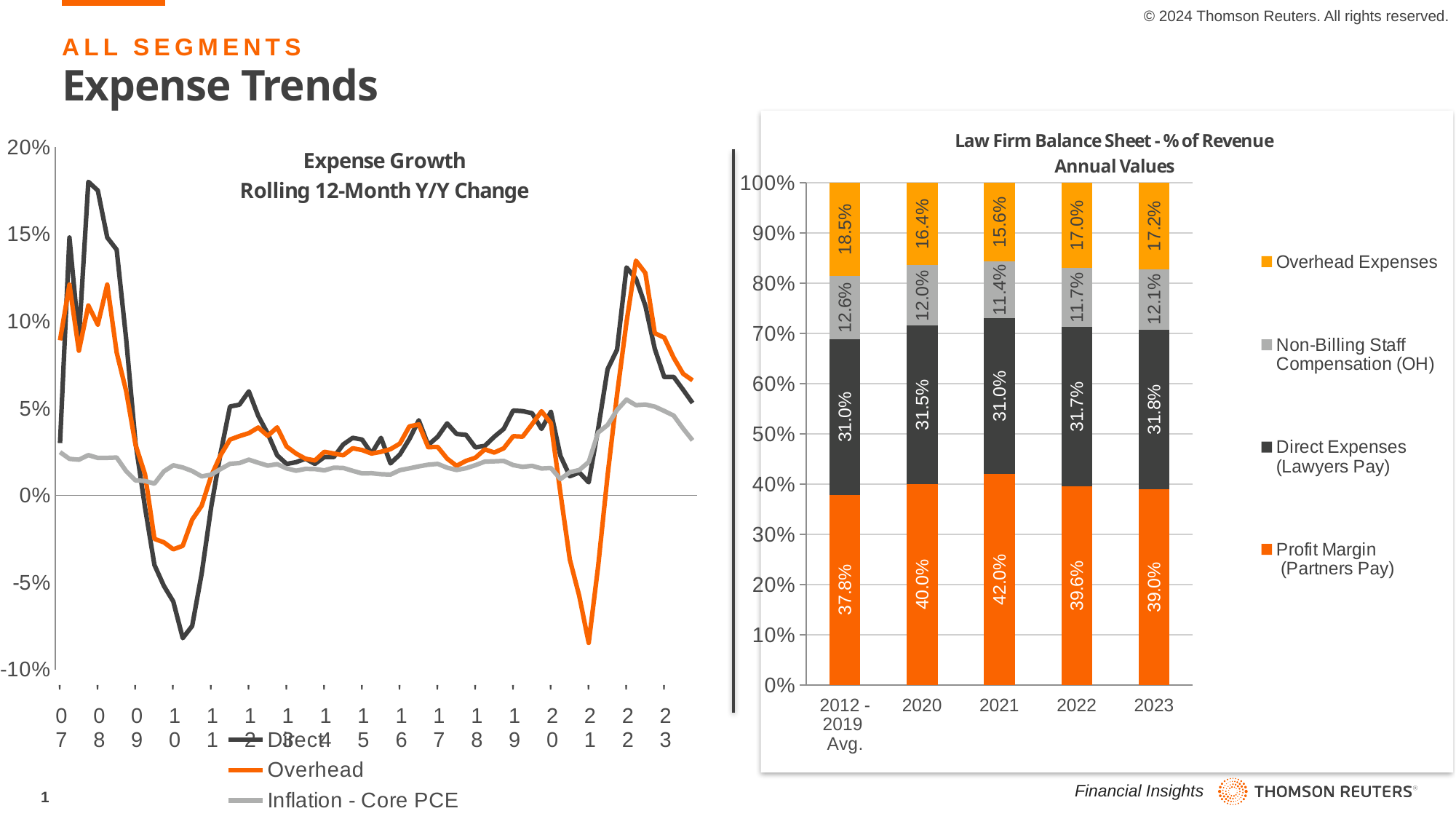
How many series does the legend of the 'Law Firm Balance Sheet - % of Revenue' chart list? 4 In the 'Expense Growth Rolling 12-Month Y/Y Change' chart, which series is drawn in grey? Inflation - Core PCE In the 'Law Firm Balance Sheet - % of Revenue' chart, is the Profit Margin (Partners Pay) larger in 2022 or 2023? 2022 How many series does the legend of the 'Expense Growth Rolling 12-Month Y/Y Change' chart list? 3 In the 'Law Firm Balance Sheet - % of Revenue' chart, what is the Profit Margin (Partners Pay) value for 2021? 42.0% In the 'Law Firm Balance Sheet - % of Revenue' chart, which category has the lowest Non-Billing Staff Compensation (OH) value? 2021 What kind of chart is the 'Expense Growth Rolling 12-Month Y/Y Change' chart on the left? Line chart In the 'Law Firm Balance Sheet - % of Revenue' chart, what is the difference between the Overhead Expenses values for the 2012-2019 Avg. and 2021? 2.9% In the 'Law Firm Balance Sheet - % of Revenue' chart, what is the Overhead Expenses value for 2020? 16.4% In the 'Law Firm Balance Sheet - % of Revenue' chart, what is the Direct Expenses (Lawyers Pay) value for 2023? 31.8% In the 'Law Firm Balance Sheet - % of Revenue' chart, which year has the highest Profit Margin (Partners Pay)? 2021 How many categories are shown on the x axis of the 'Law Firm Balance Sheet - % of Revenue' chart? 5